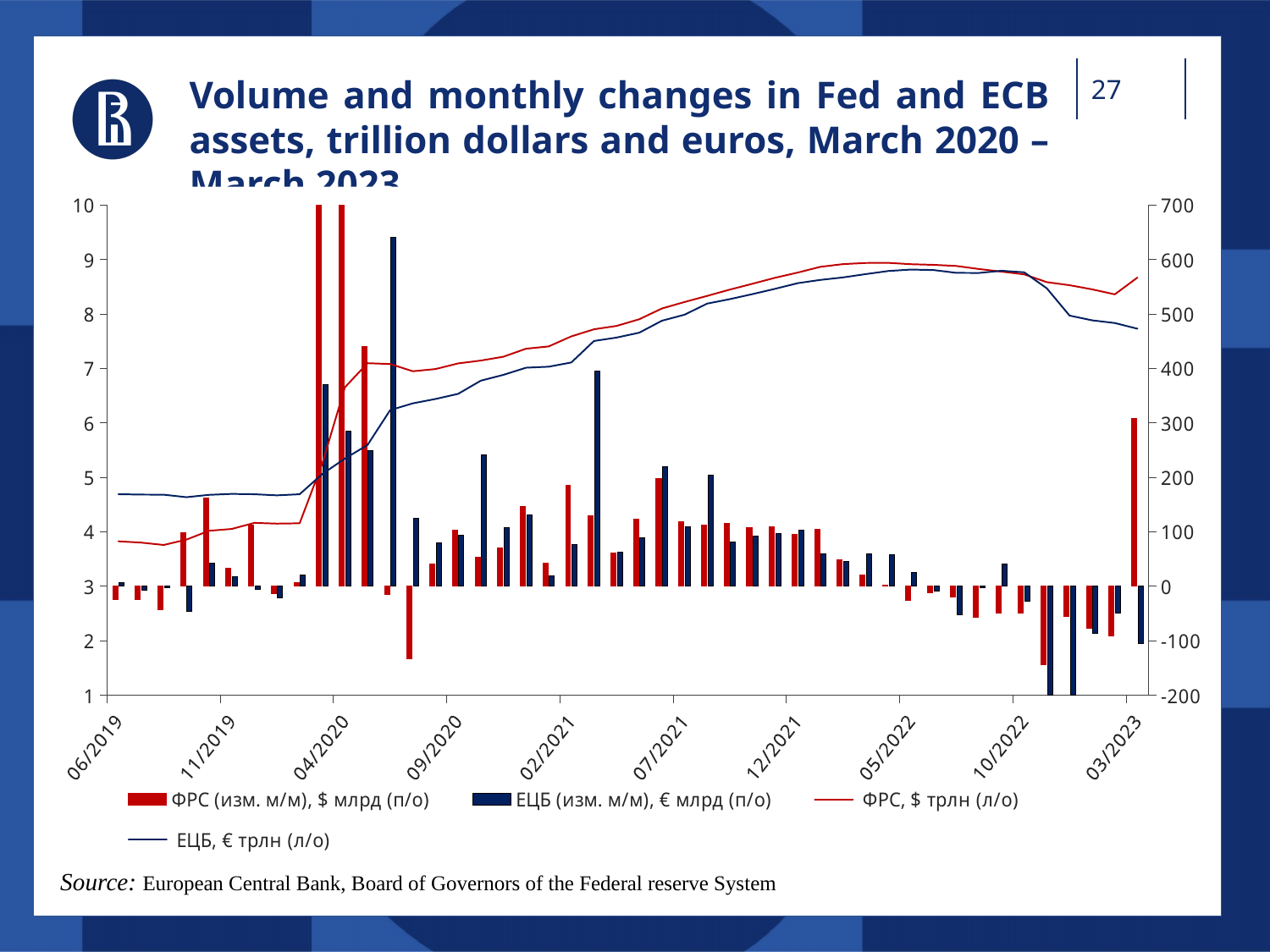
Is the value of the ЕЦБ, € трлн line at 03/2023 greater or less than 7 on the left axis? greater Is the value of the ФРС, $ трлн line at 06/2019 greater or less than 5 on the left axis? less What kind of chart is shown on the slide? A combination chart with bars and lines What is the highest tick value shown on the right-hand axis? 700 How many series does the legend list? 4 Does the ФРС, $ трлн line rise or fall between 06/2019 and 05/2022? rise How many date labels are shown along the x axis? 10 Is the value of the ФРС, $ трлн line at 05/2022 greater or less than 8 on the left axis? greater Which organisations are named as the source of the chart data? European Central Bank, Board of Governors of the Federal reserve System At 03/2023, which line is higher on the left axis: ФРС, $ трлн or ЕЦБ, € трлн? ФРС, $ трлн Does the ЕЦБ, € трлн line rise or fall between 10/2022 and 03/2023? fall